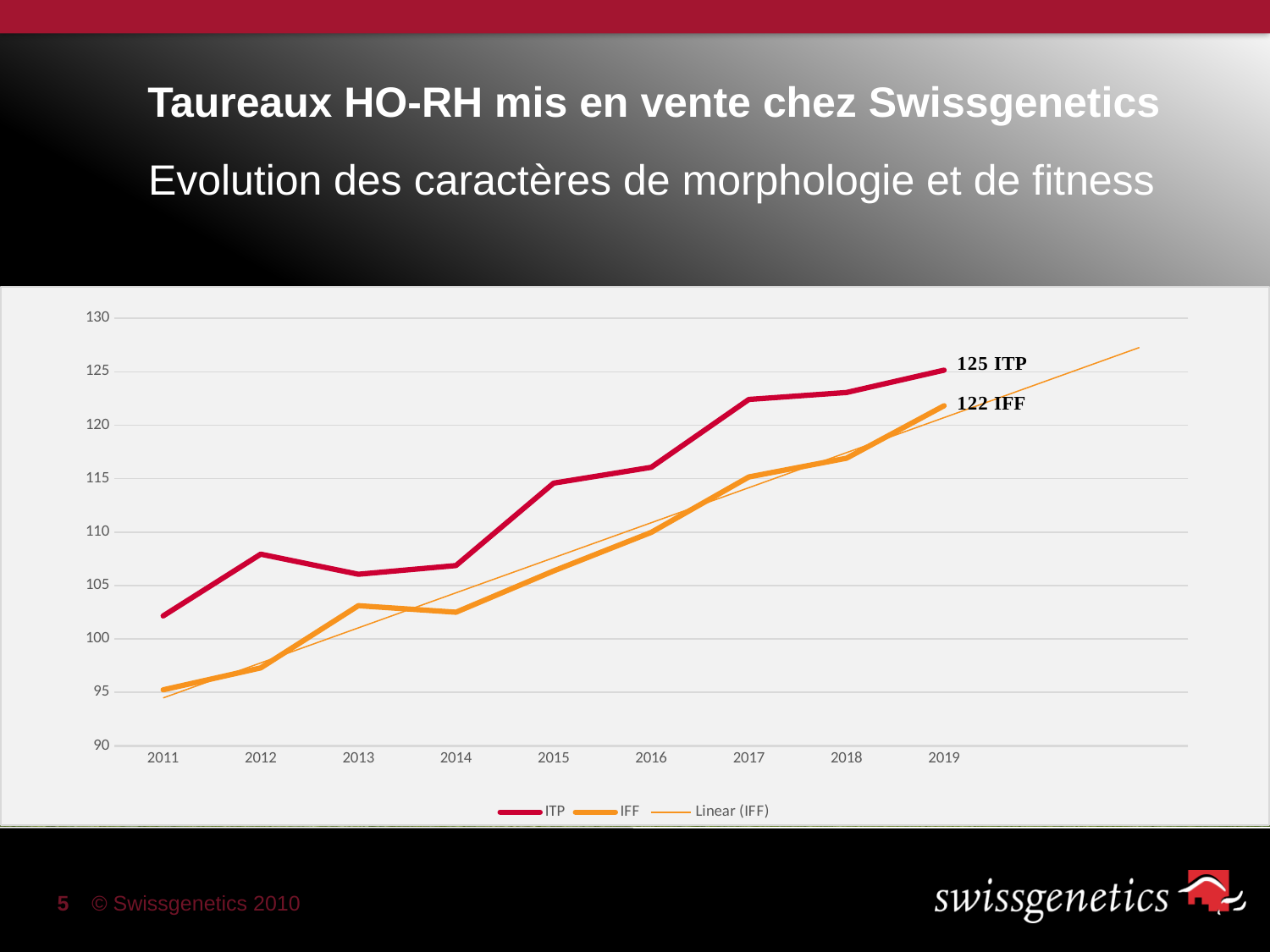
Is the ITP value for 2017 greater or less than 120? greater What is the IFF value in 2019? 122 Is the IFF value for 2011 greater or less than 100? less Is the ITP value for 2011 greater or less than 100? greater Does the IFF series generally rise or fall from 2011 to 2019? rise What colour is the ITP line? red How many entries does the legend list? 3 How many years are shown on the x axis? 9 What is the difference between the ITP and IFF values in 2019? 3 What type of chart is shown on the slide? line chart What is the ITP value in 2019? 125 In 2019, which series has the higher value, ITP or IFF? ITP